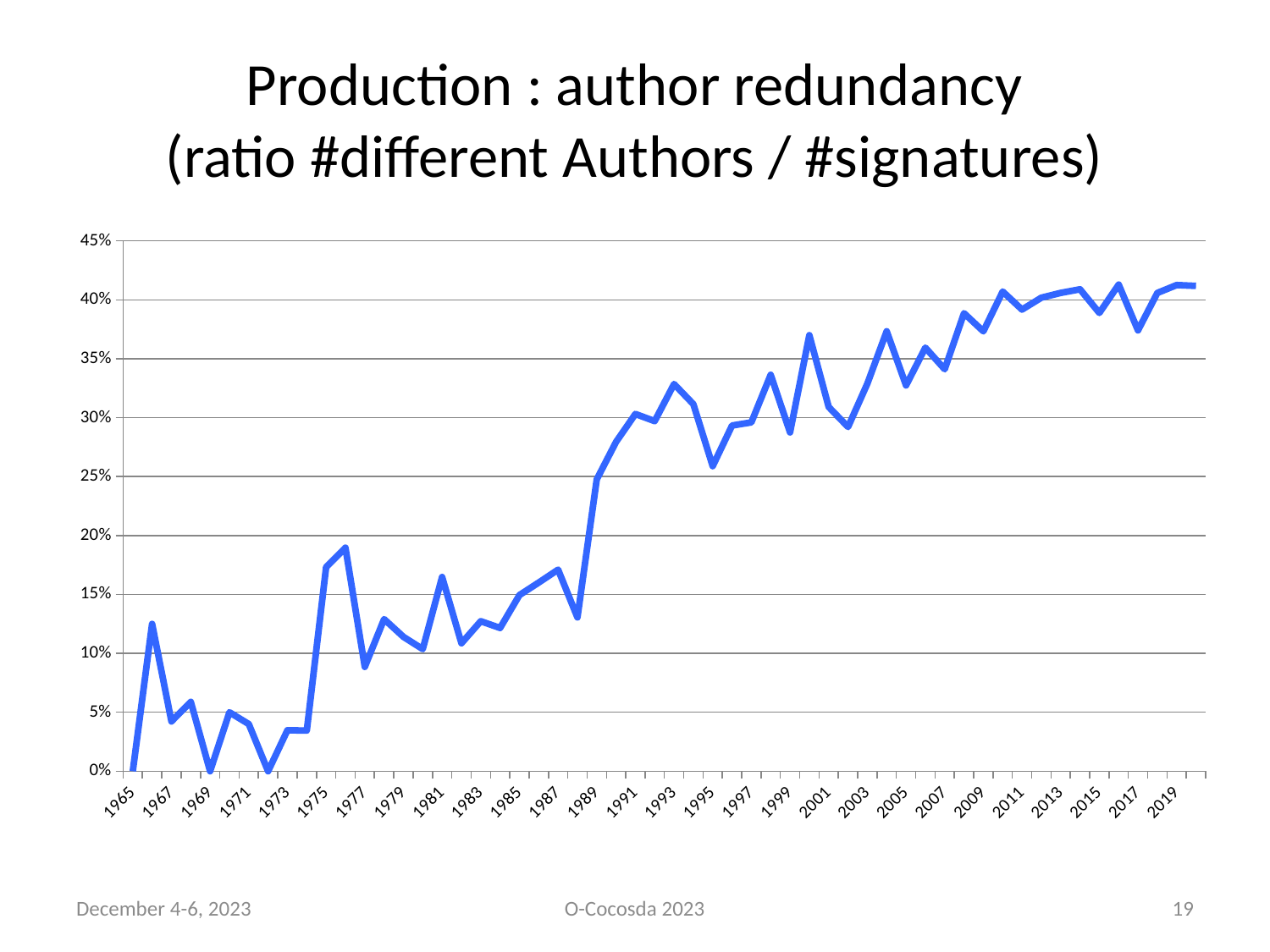
Is the value for 1976 greater or less than 15%? greater Which year has the larger value, 1976 or 1977? 1976 What is the lowest value plotted on the chart? 0% Is the value for 1977 greater or less than 10%? less Is the value for 2017 greater or less than 40%? less What is the title of the chart on the slide? Production : author redundancy (ratio #different Authors / #signatures) What kind of chart is shown on the slide? line chart What is the value for 1969? 0% What is the value for 1965? 0% Overall, do the values rise or fall from 1965 to 2019? rise Which year has the larger value, 1990 or 2000? 2000